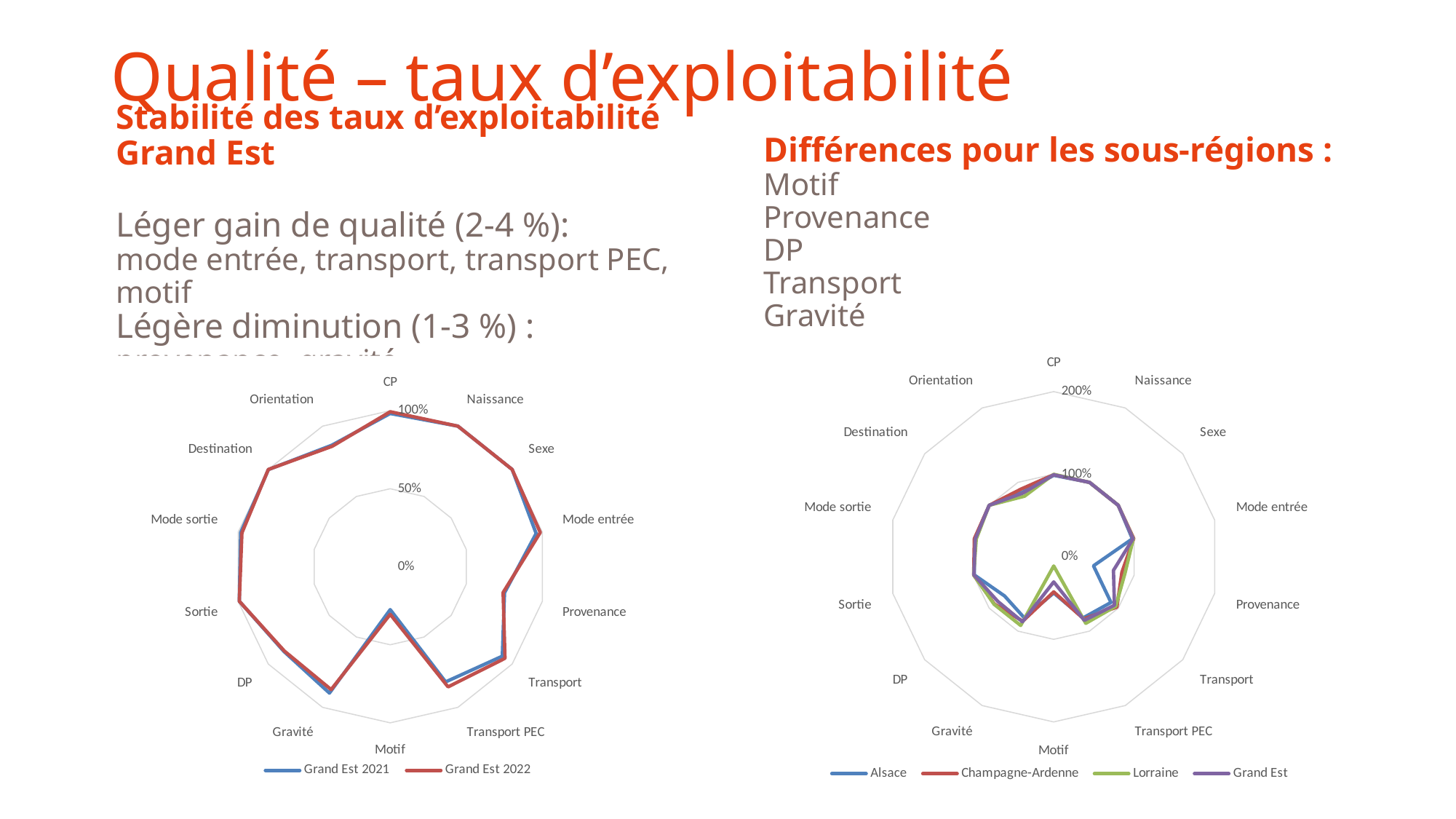
In the left chart, which is larger for Grand Est 2022: Transport PEC or Motif? Transport PEC In the right chart, is the value for Motif for Lorraine greater or less than 100%? less In the right chart, which series is drawn in purple? Grand Est What kind of chart is the right chart (Alsace, Champagne-Ardenne, Lorraine, Grand Est)? Radar chart In the left chart, is the value for CP (Grand Est 2022) greater or less than 50%? greater In the left chart, which category has the lowest value for Grand Est 2022? Motif How many categories (axes) does the left chart have? 14 How many series does the legend of the left chart list? 2 In the right chart, which category has the lowest value for Alsace? Motif What kind of chart is the left chart (Grand Est 2021 vs 2022)? Radar chart How many series does the legend of the right chart list? 4 In the left chart, is the value for Motif (Grand Est 2022) greater or less than 50%? less